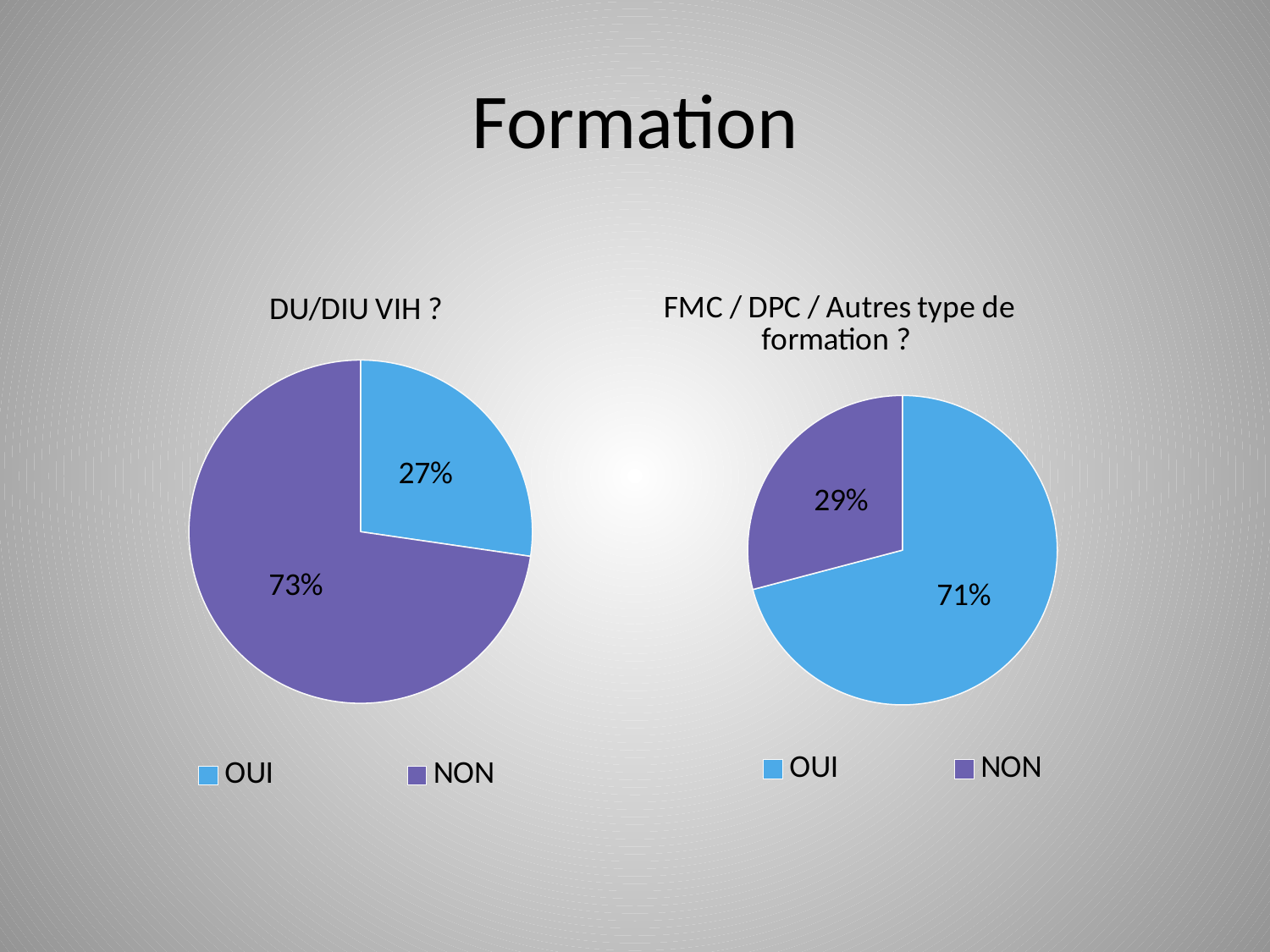
In the "FMC / DPC / Autres type de formation ?" chart, what is the difference between the OUI and NON shares? 42% What is the title of the chart on the right of the slide? FMC / DPC / Autres type de formation ? What type of chart is the "DU/DIU VIH ?" chart? Pie chart In the "DU/DIU VIH ?" chart, what is the difference between the NON and OUI shares? 46% In the "DU/DIU VIH ?" chart, what share of the pie is OUI? 27% In the "DU/DIU VIH ?" chart, what share of the pie is NON? 73% In the "FMC / DPC / Autres type de formation ?" chart, what share of the pie is NON? 29% How many categories does the legend of the "DU/DIU VIH ?" chart list? 2 In the "FMC / DPC / Autres type de formation ?" chart, which is larger, OUI or NON? OUI In the "DU/DIU VIH ?" chart, which category has the largest slice? NON In the "FMC / DPC / Autres type de formation ?" chart, which category has the smallest slice? NON